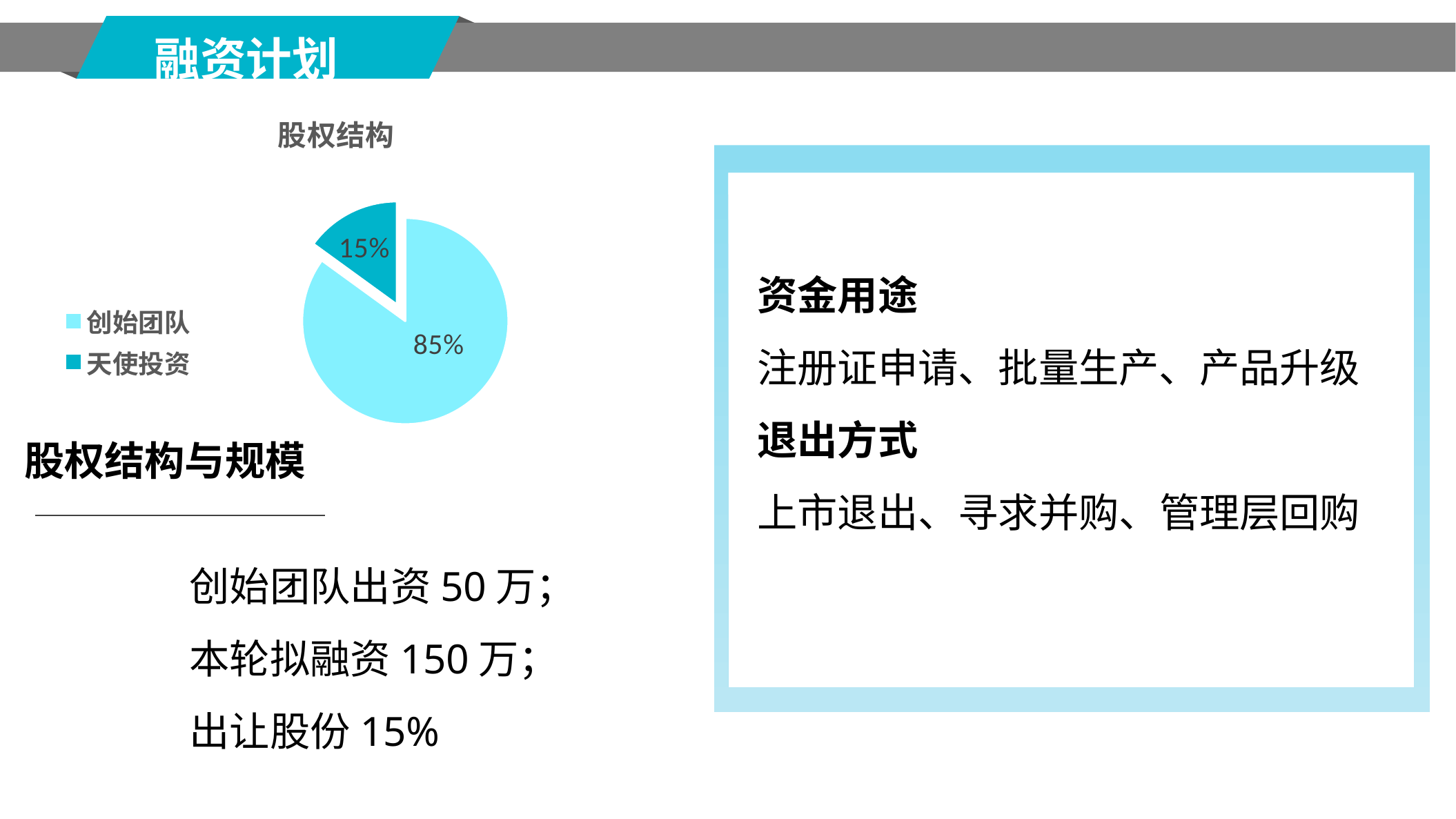
Which category has the smallest slice in the pie chart? 天使投资 Which category has the largest slice in the pie chart? 创始团队 Which legend entry is shown in the darker teal colour? 天使投资 How many slices does the pie chart have? 2 How many entries does the legend list? 2 What share of the pie does 天使投资 hold? 15% What share of the pie does 创始团队 hold? 85% What is the difference in percentage points between the 创始团队 and 天使投资 slices? 70% What is the title of the chart? 股权结构 What type of chart is shown on the slide? pie chart Which slice is larger, 创始团队 or 天使投资? 创始团队